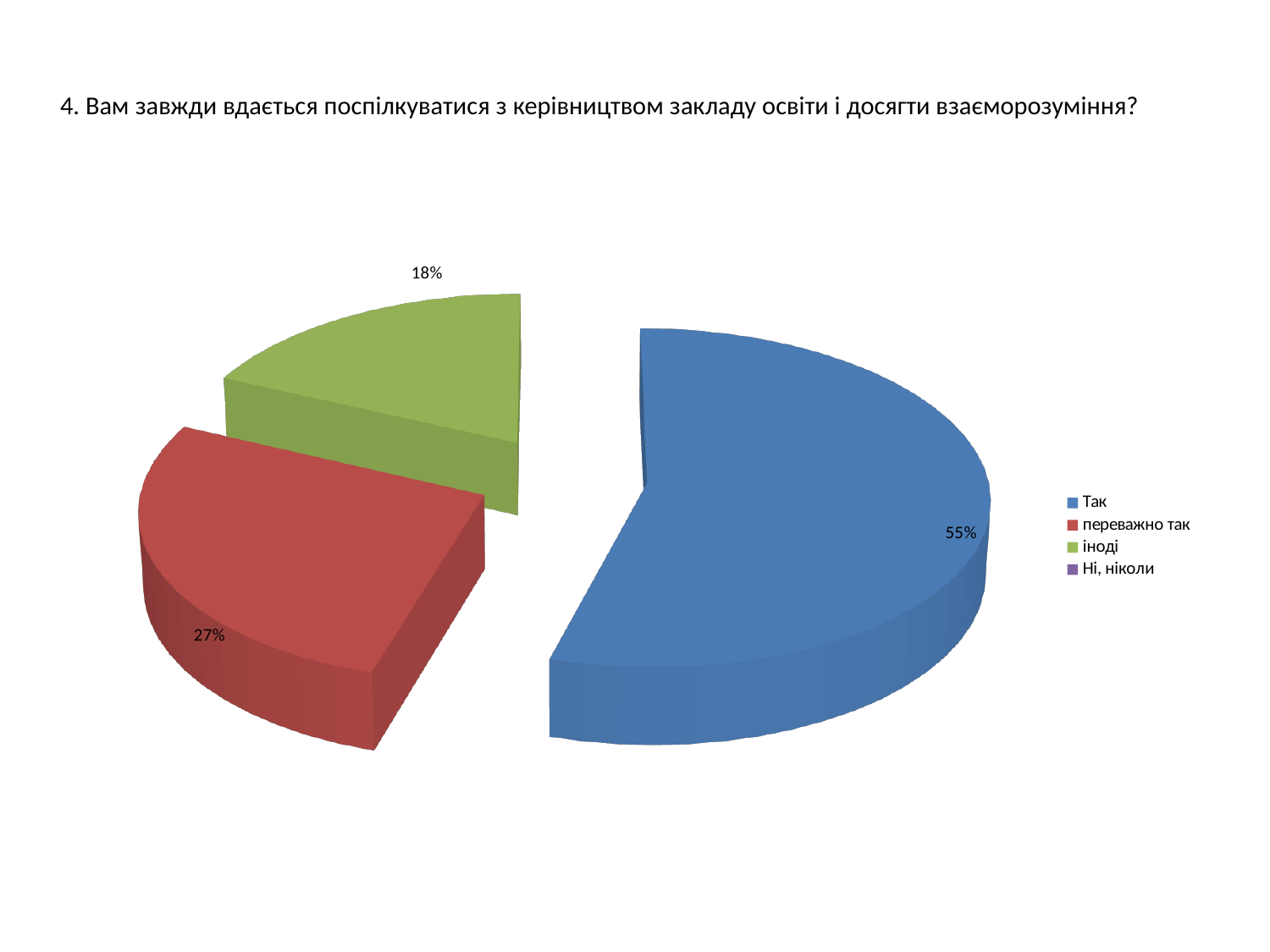
Which legend entry has no visible slice in the pie? Ні, ніколи What share of the pie does "іноді" represent? 18% What is the difference in percentage points between "Так" and "переважно так"? 28 Which is larger, the slice for "переважно так" or the slice for "іноді"? переважно так What is the difference in percentage points between "переважно так" and "іноді"? 9 How many entries does the legend list? 4 Which category has the largest slice of the pie? Так Which of the visible slices is the smallest? іноді What share of the pie does "переважно так" represent? 27% What kind of chart is shown on the slide? Pie chart What share of the pie does "Так" represent? 55% What colour is the slice for "Так"? Blue